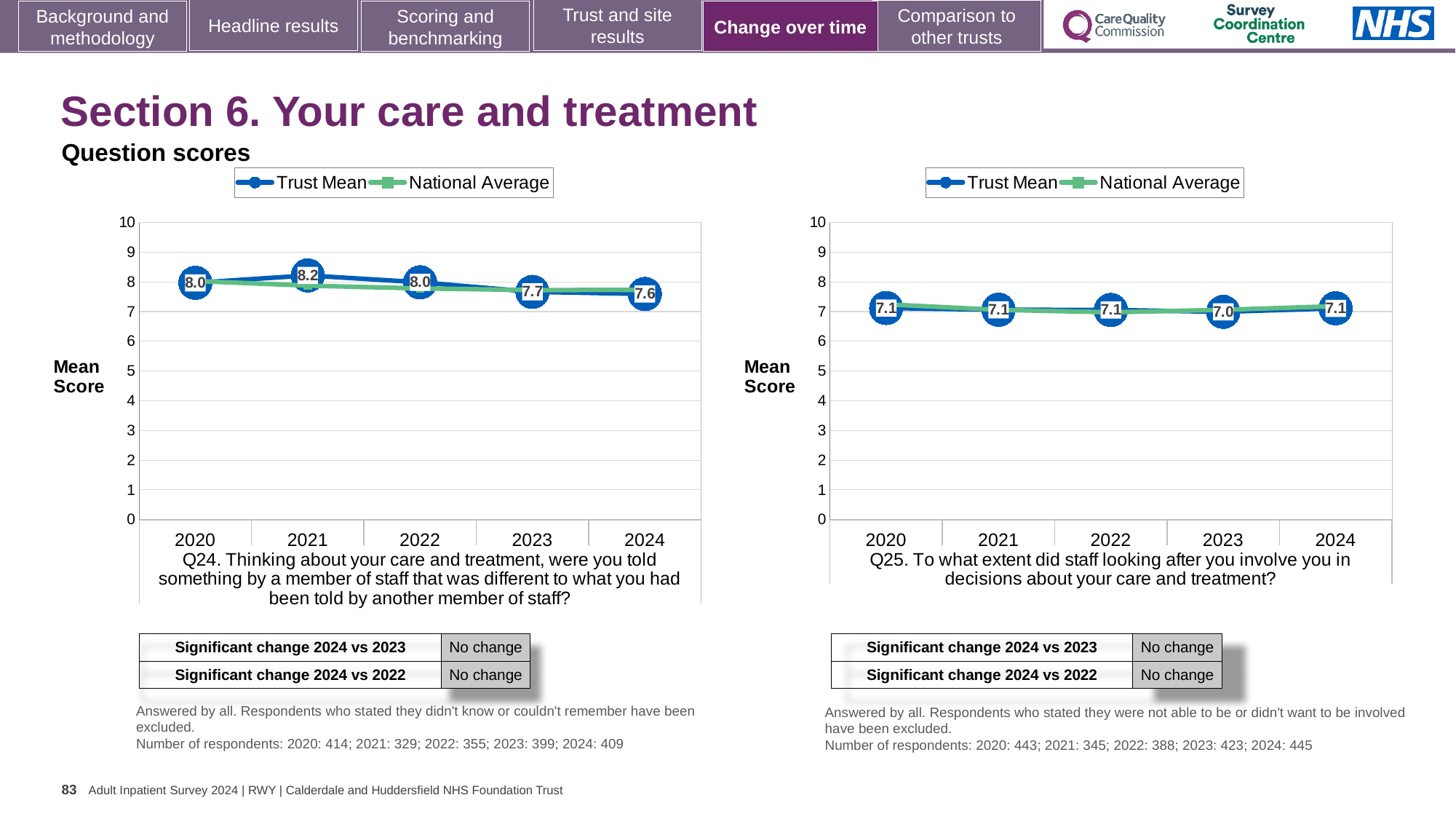
In the Q24 chart on the left, what is the Trust Mean score for 2021? 8.2 How many series does the legend of the Q24 chart on the left list? 2 In the Q24 chart on the left, which year has the highest Trust Mean score? 2021 In the Q24 chart on the left, what is the difference between the Trust Mean scores for 2021 and 2024? 0.6 In the Q25 chart on the right, which year has the lowest Trust Mean score? 2023 How many years are plotted on the x axis of the Q25 chart on the right? 5 In the Q24 chart on the left, what is the Trust Mean score for 2024? 7.6 In the Q24 chart on the left, does the Trust Mean score generally rise or fall from 2021 to 2024? fall In the Q25 chart on the right, is the Trust Mean score for 2024 greater or less than 8? less In the Q24 chart on the left, which year has the lowest Trust Mean score? 2024 Which is larger: the Trust Mean score for 2020 in the Q24 chart or the Trust Mean score for 2020 in the Q25 chart? Q24 chart (8.0) In the Q25 chart on the right, what is the Trust Mean score for 2023? 7.0